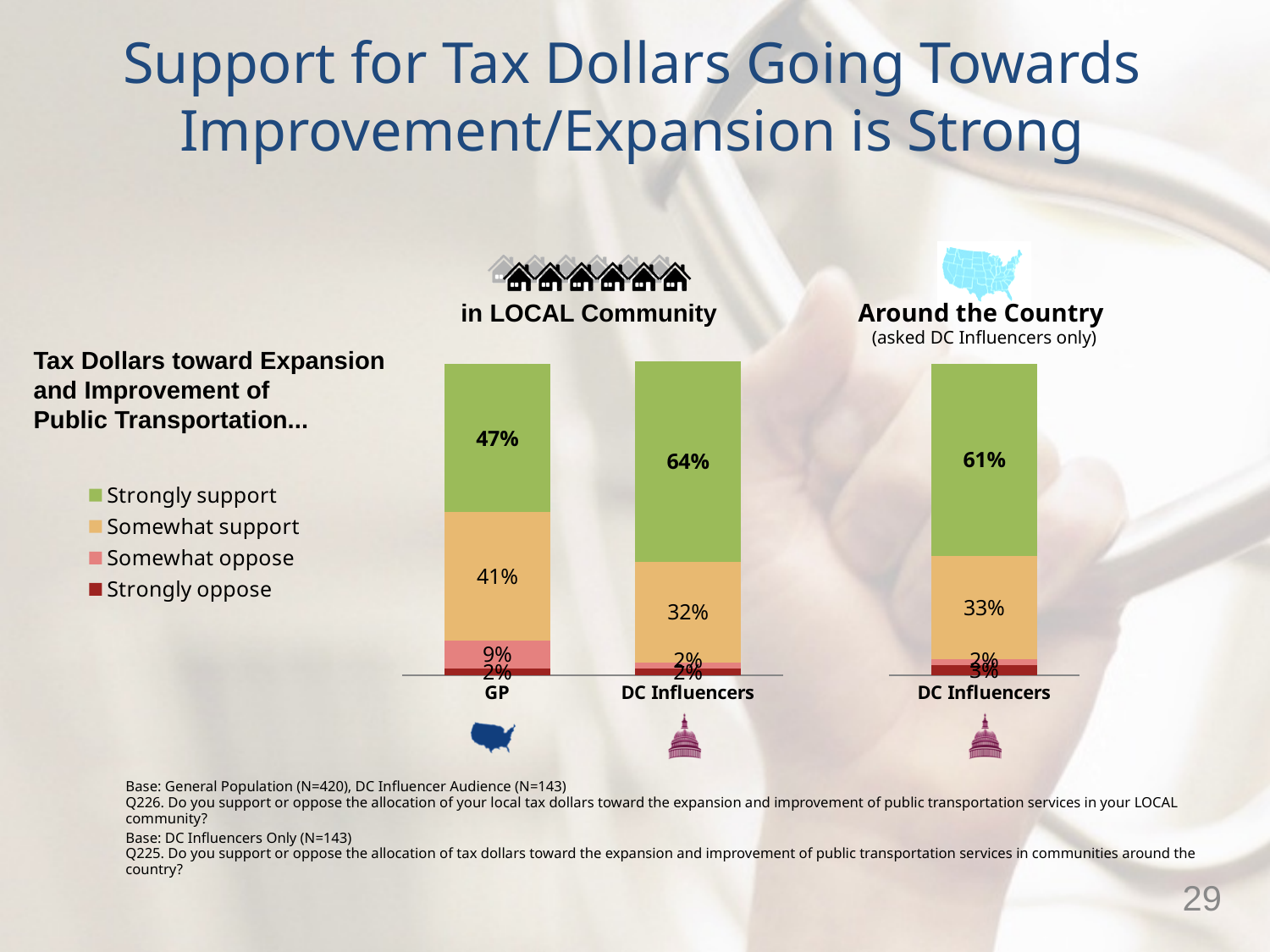
What type of chart is used on this slide? Stacked bar chart What percentage of DC Influencers strongly support tax dollars toward public transportation Around the Country? 61% What percentage of DC Influencers strongly support tax dollars toward public transportation in their LOCAL community? 64% How many percentage points higher is 'Strongly support' for DC Influencers in the LOCAL community than for the GP? 17 percentage points What percentage of DC Influencers somewhat support tax dollars toward public transportation in their LOCAL community? 32% Which group has the larger 'Somewhat support' share in the LOCAL community: GP or DC Influencers? GP What percentage of the GP somewhat supports tax dollars toward public transportation in their LOCAL community? 41% What percentage of DC Influencers somewhat support tax dollars toward public transportation Around the Country? 33% What percentage of the GP somewhat opposes tax dollars toward public transportation in their LOCAL community? 9% How many response categories does the legend list? 4 What percentage of the GP (general population) strongly supports tax dollars toward expansion and improvement of public transportation in their LOCAL community? 47% Which bar shows the highest 'Strongly support' percentage? DC Influencers in LOCAL Community